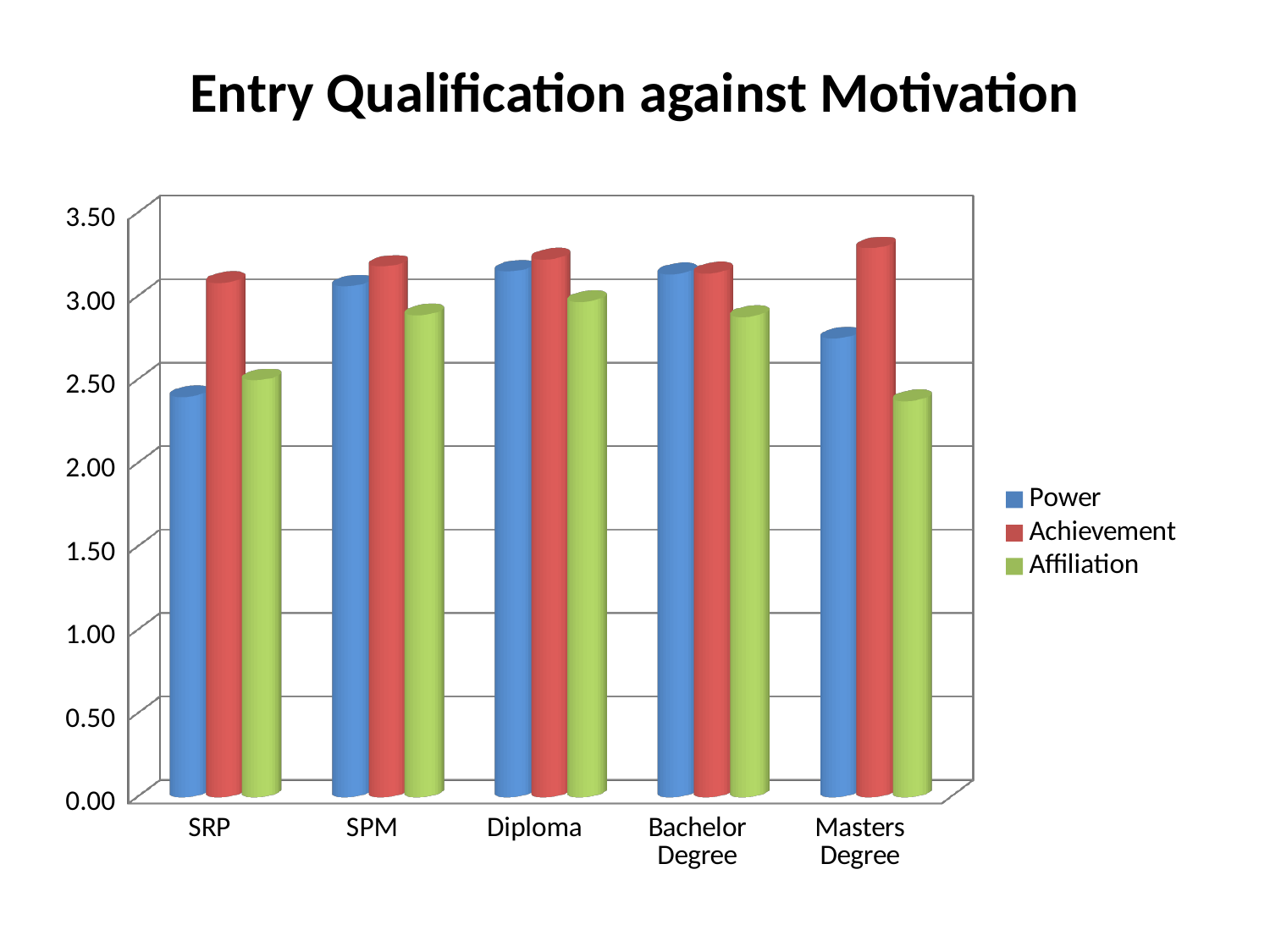
Is the Affiliation value for Masters Degree greater or less than 2.50? less Which series is shown in red in the legend? Achievement Is the Power value for SRP greater or less than 2.50? less For SRP, which series has the highest value? Achievement What kind of chart is shown on the slide? bar chart What is the title of the chart? Entry Qualification against Motivation How many entry qualification categories are shown on the x axis? 5 How many series does the legend list? 3 Is the Achievement value for SRP greater or less than 3.00? greater For Masters Degree, which is larger, the Power value or the Affiliation value? Power For which entry qualification is the Power value lowest? SRP